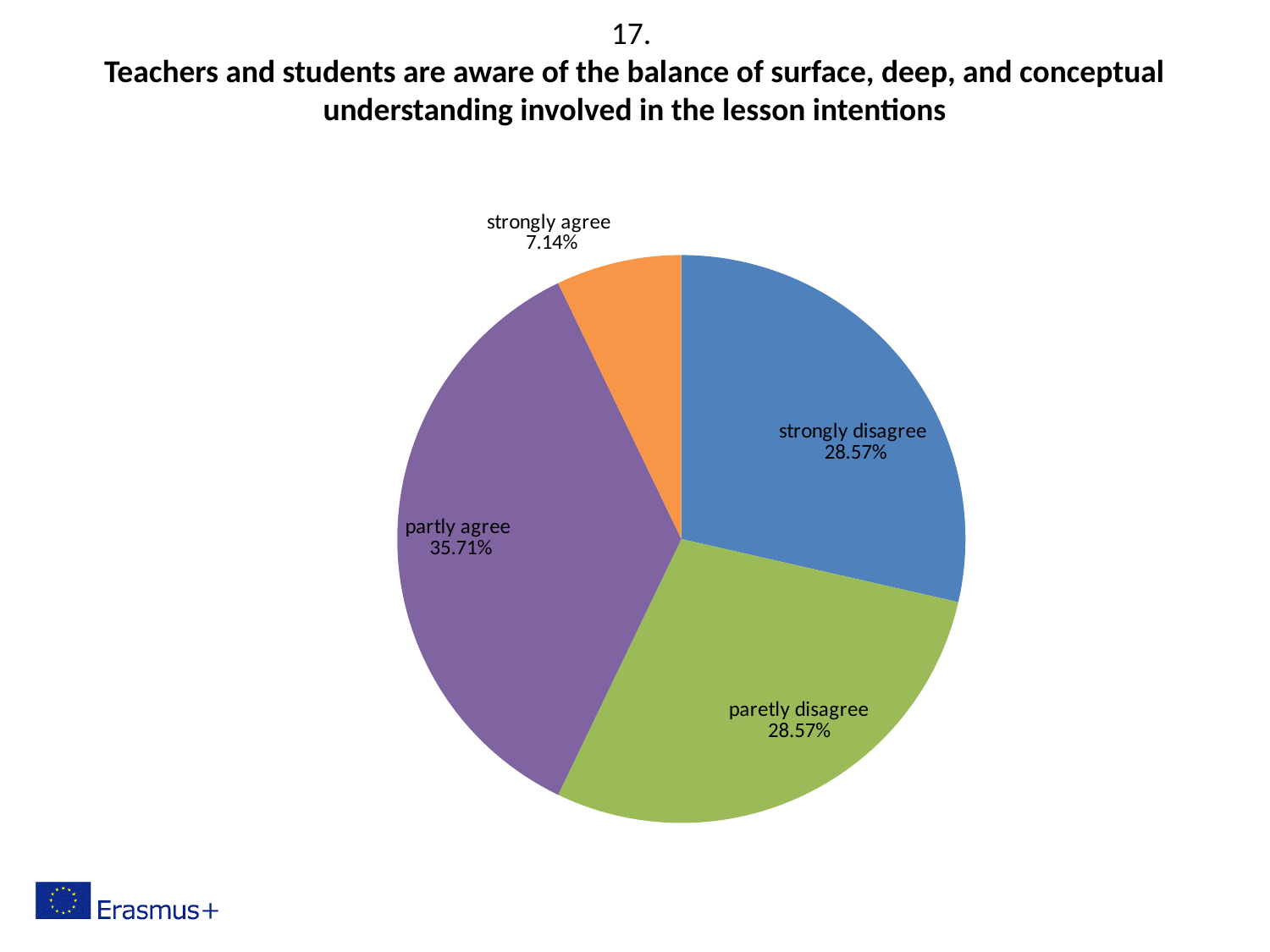
What colour is the 'strongly agree' slice? orange What percentage of respondents chose 'strongly disagree'? 28.57% What kind of chart is shown on the slide? pie chart What percentage of respondents chose 'partly agree'? 35.71% Which response category has the largest share of the pie? partly agree What percentage of respondents chose 'strongly agree'? 7.14% Which response category has the smallest share of the pie? strongly agree What percentage of respondents chose 'paretly disagree'? 28.57% How many slices does the pie chart have? 4 What is the difference in percentage points between 'partly agree' and 'strongly agree'? 28.57 Which is larger, the share for 'partly agree' or the share for 'strongly disagree'? partly agree What is the combined share of 'strongly disagree' and 'paretly disagree'? 57.14%